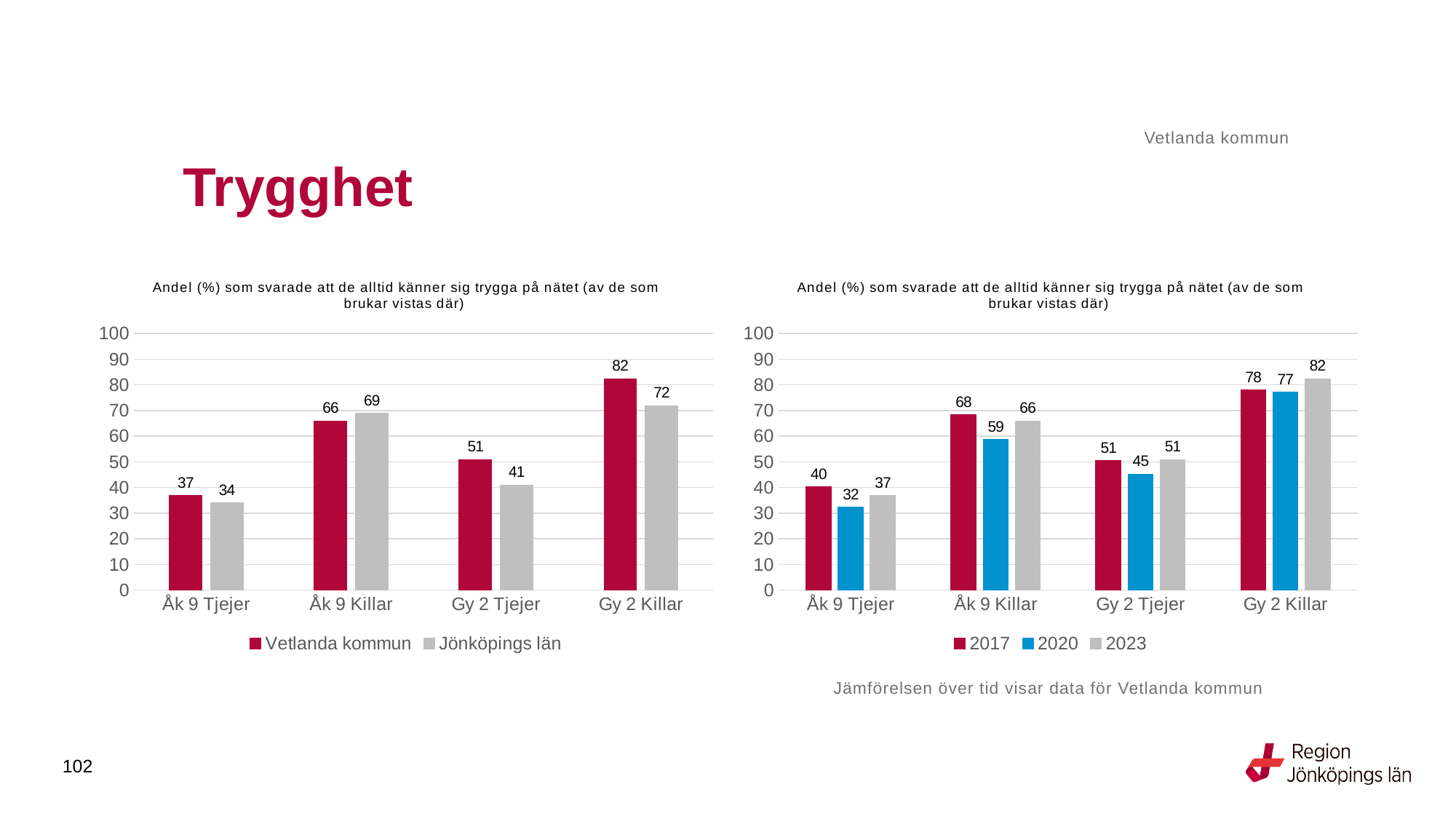
In the left chart, which category has the lowest value for Jönköpings län? Åk 9 Tjejer In the right chart, what is the value for 2023 for Gy 2 Killar? 82 In the left chart, what is the value for Jönköpings län for Gy 2 Tjejer? 41 In the left chart, which category has the highest value for Vetlanda kommun? Gy 2 Killar How many series does the legend of the right chart list? 3 What kind of chart is the left chart? Bar chart In the right chart, what is the value for 2020 for Åk 9 Killar? 59 In the left chart, which is larger for Åk 9 Killar: Vetlanda kommun or Jönköpings län? Jönköpings län In the left chart, what is the difference between Vetlanda kommun and Jönköpings län for Gy 2 Killar? 10 In the left chart, what is the value for Vetlanda kommun for Åk 9 Tjejer? 37 In the right chart, which year has the lowest value for Åk 9 Tjejer? 2020 In the right chart, what is the difference between 2017 and 2020 for Gy 2 Tjejer? 6